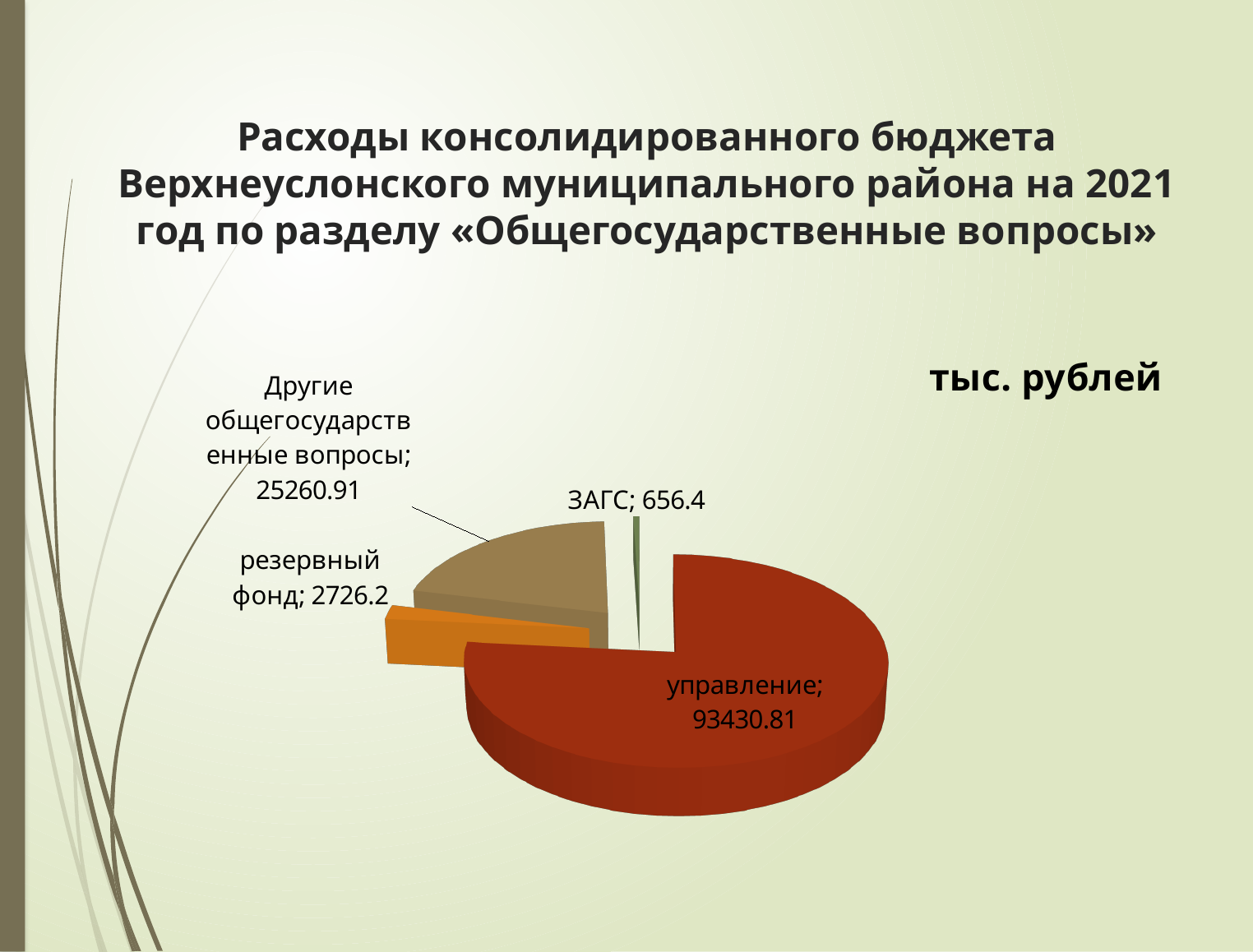
What is the value for управление? 93430.81 How many slices does the pie chart have? 4 What kind of chart is shown on the slide? pie chart What is the value for ЗАГС? 656.4 What is the value for резервный фонд? 2726.2 Which is larger, the value for резервный фонд or the value for ЗАГС? резервный фонд In what units are the values on the chart given? тыс. рублей What is the difference between the values for управление and Другие общегосударственные вопросы? 68169.9 What is the difference between the values for резервный фонд and ЗАГС? 2069.8 Which category has the smallest slice of the pie? ЗАГС Which category has the largest slice of the pie? управление What is the value for Другие общегосударственные вопросы? 25260.91